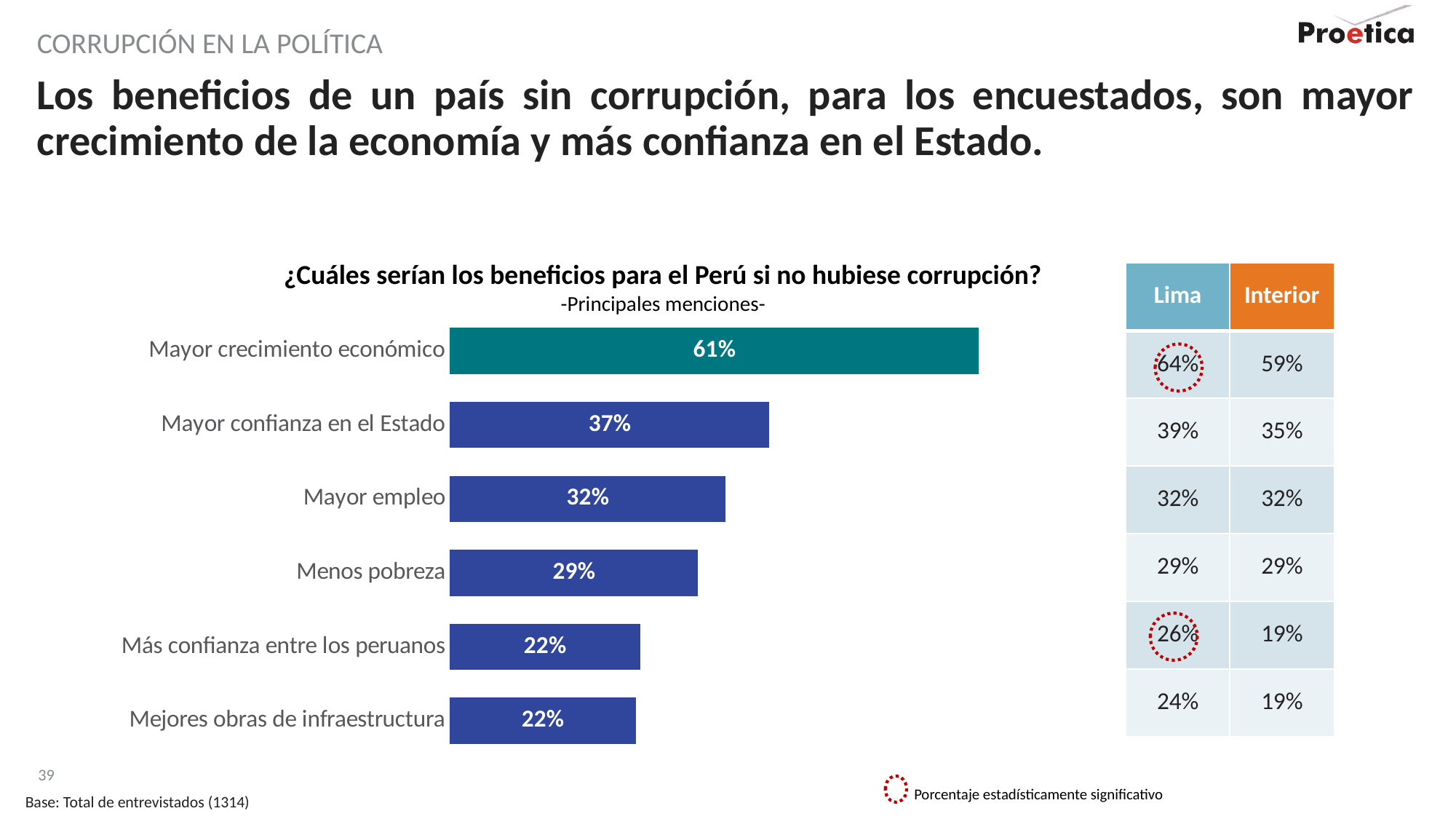
What percentage of respondents mentioned 'Mayor crecimiento económico' as a benefit? 61% How many benefit categories are shown in the bar chart? 6 What kind of chart is used to show the benefits? Bar chart What is the value shown for 'Menos pobreza'? 29% What is the value shown for 'Mayor confianza en el Estado'? 37% What is the title question of the chart? ¿Cuáles serían los beneficios para el Perú si no hubiese corrupción? Which bar is shown in a different colour (teal) from the others? Mayor crecimiento económico Which two categories share the same value of 22%? Más confianza entre los peruanos and Mejores obras de infraestructura What is the difference in percentage points between 'Mayor empleo' and 'Más confianza entre los peruanos'? 10 Which has a larger value: 'Mayor empleo' or 'Menos pobreza'? Mayor empleo What is the difference in percentage points between 'Mayor crecimiento económico' and 'Mayor confianza en el Estado'? 24 Which benefit has the highest percentage of mentions? Mayor crecimiento económico